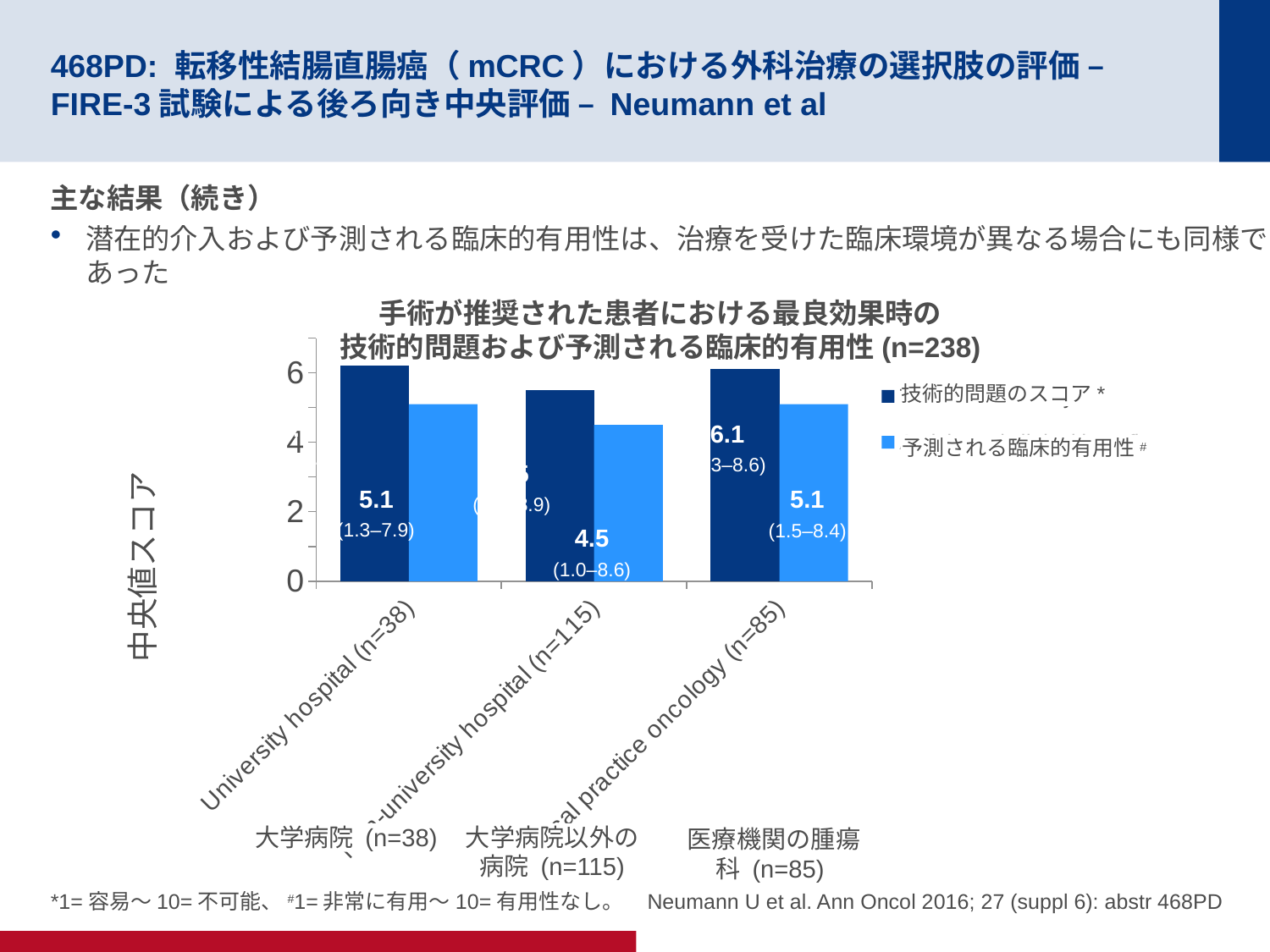
What is the 技術的問題のスコア (technical problems score) for 医療機関の腫瘍科 (General practice oncology, n=85)? 6.1 How many categories (clinical settings) are shown on the x axis of the chart? 3 Which clinical setting has the lowest 予測される臨床的有用性 (predicted clinical benefit) score? 大学病院以外の病院 (Non-university hospital, n=115) What kind of chart is shown on the slide? bar chart For 医療機関の腫瘍科 (General practice oncology), which is larger: the 技術的問題のスコア or the 予測される臨床的有用性 score? 技術的問題のスコア How many series does the chart legend list? 2 What is the label on the y axis of the chart? 中央値スコア What is the 予測される臨床的有用性 (predicted clinical benefit) score for 医療機関の腫瘍科 (General practice oncology, n=85)? 5.1 What is the 予測される臨床的有用性 (predicted clinical benefit) score for 大学病院以外の病院 (Non-university hospital, n=115)? 4.5 Is the 技術的問題のスコア for 大学病院以外の病院 (Non-university hospital, n=115) greater or less than 4? greater For 医療機関の腫瘍科 (General practice oncology), what is the difference between the 技術的問題のスコア (6.1) and the 予測される臨床的有用性 score (5.1)? 1.0 Is the 技術的問題のスコア for 大学病院 (University hospital, n=38) greater or less than 6? greater